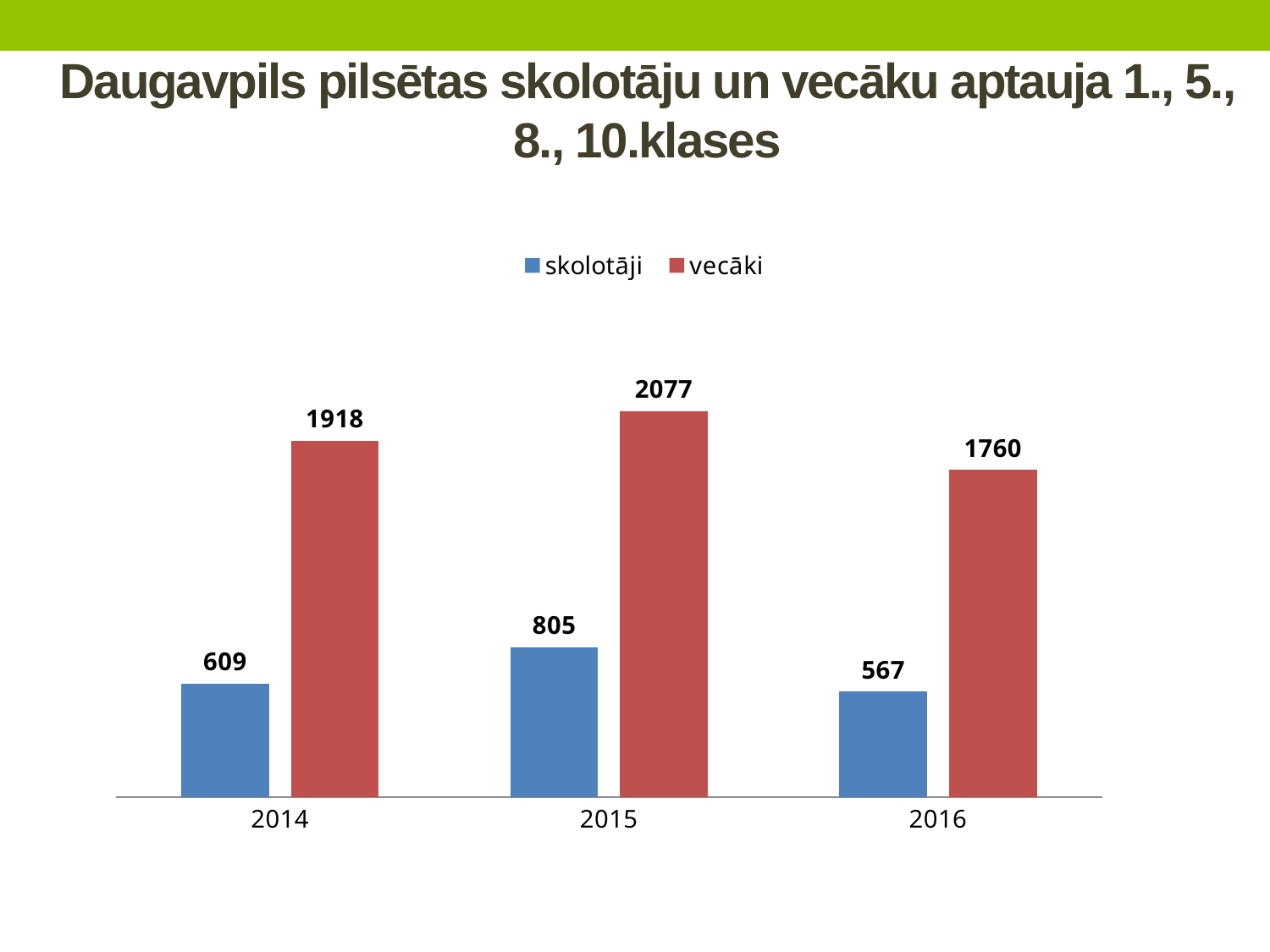
Which colour represents the vecāki series? red In which year is the vecāki value highest? 2015 In which year is the skolotāji value lowest? 2016 What kind of chart is shown on the slide? bar chart How many years are shown on the x axis? 3 What is the difference between the vecāki and skolotāji values in 2014? 1309 What is the value for skolotāji in 2015? 805 What is the value for vecāki in 2016? 1760 How many series does the legend list? 2 Which is larger, the skolotāji value in 2014 or in 2016? 2014 What is the value for skolotāji in 2014? 609 What is the difference between the vecāki values for 2015 and 2016? 317